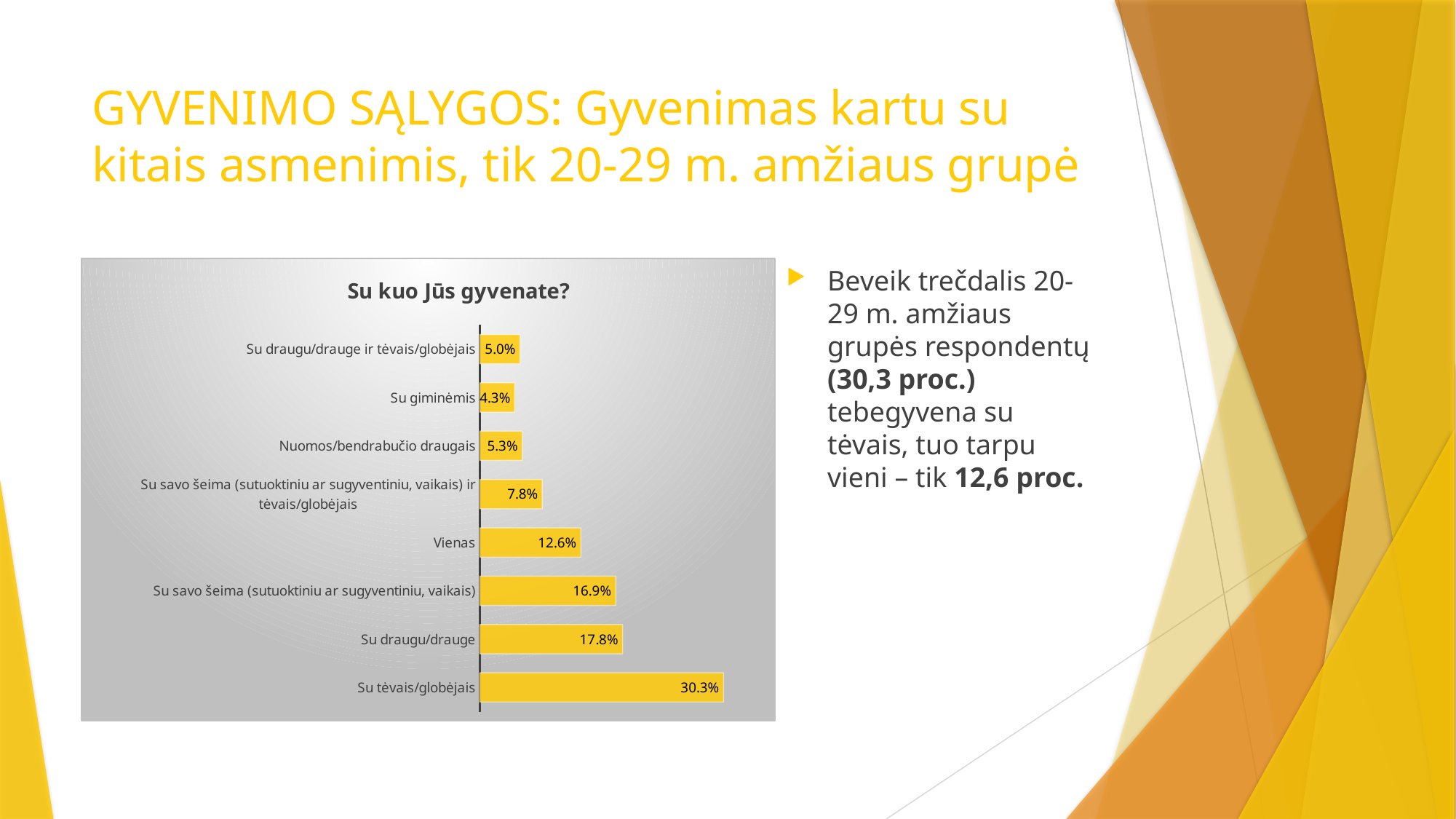
Which is larger, the value for "Su draugu/drauge ir tėvais/globėjais" or the value for "Nuomos/bendrabučio draugais"? Nuomos/bendrabučio draugais What is the difference between the values for "Su draugu/drauge" and "Su savo šeima (sutuoktiniu ar sugyventiniu, vaikais)"? 0.9% What kind of chart is shown on the slide? Bar chart What is the difference between the values for "Su tėvais/globėjais" and "Vienas"? 17.7% How many categories are shown in the chart? 8 Which category has the lowest value? Su giminėmis What is the value for "Nuomos/bendrabučio draugais"? 5.3% What is the value for "Su giminėmis"? 4.3% Which category has the highest value? Su tėvais/globėjais What is the title of the chart? Su kuo Jūs gyvenate? What is the value for "Vienas"? 12.6% What is the value for "Su tėvais/globėjais"? 30.3%